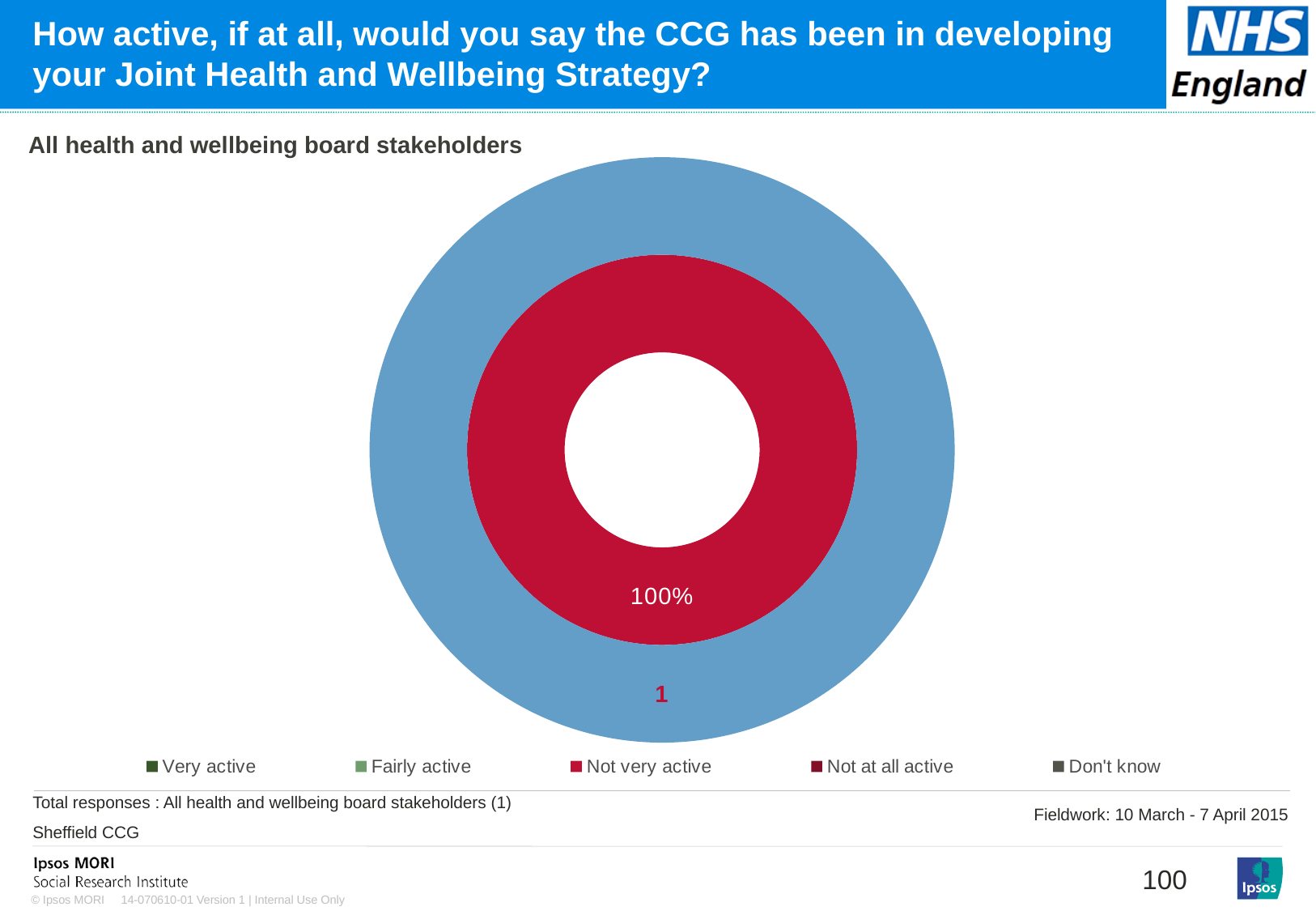
What is the number printed in red below the doughnut chart? 1 What percentage is shown on the red segment of the doughnut chart? 100% What is the last entry in the chart legend? Don't know What kind of chart is shown on the slide? doughnut chart What is the total number of responses stated on the slide? 1 How many response categories are visibly plotted as segments in the doughnut chart? 1 Which response category does the red segment of the doughnut chart represent? Not very active What is the first entry in the chart legend? Very active Which response category has the highest share in the doughnut chart? Not very active What share of the doughnut chart does 'Not very active' take up? 100% How many entries does the legend list? 5 Which CCG does the chart relate to? Sheffield CCG